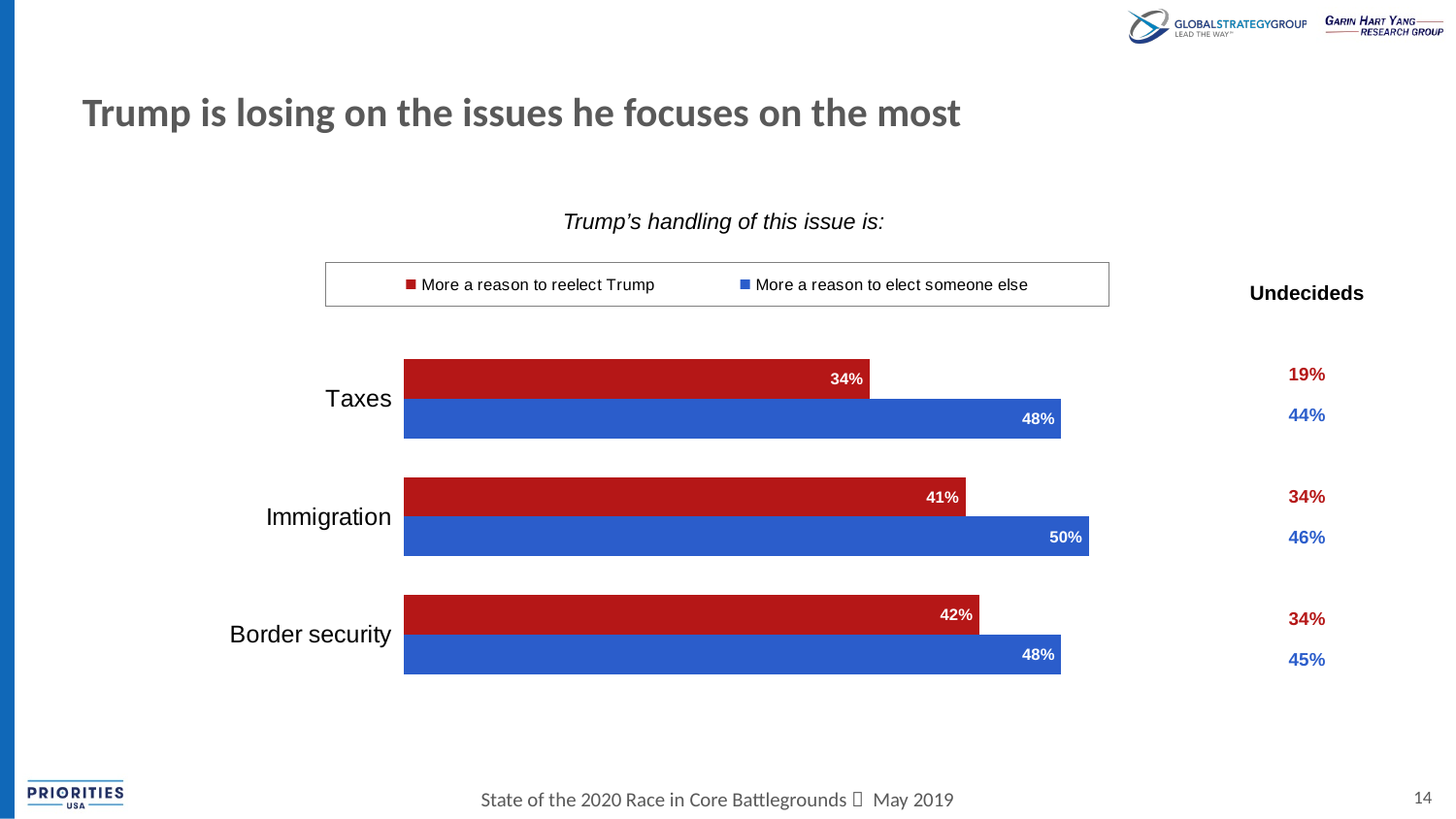
What is the value for Border security in the 'More a reason to reelect Trump' series? 42% What is the value for Taxes in the 'More a reason to elect someone else' series? 48% Which issue has the highest value for 'More a reason to elect someone else'? Immigration For Immigration, which is larger: 'More a reason to reelect Trump' or 'More a reason to elect someone else'? More a reason to elect someone else What type of chart is shown on the slide? Bar chart Which issue has the lowest value for 'More a reason to reelect Trump'? Taxes What percentage say Trump's handling of immigration is more a reason to elect someone else? 50% How many series does the legend list? 2 What colour are the bars for 'More a reason to reelect Trump'? Red What is the difference between the 'More a reason to elect someone else' and 'More a reason to reelect Trump' values for Taxes? 14 percentage points How many issues are shown in the chart? 3 What percentage say Trump's handling of taxes is more a reason to reelect Trump? 34%